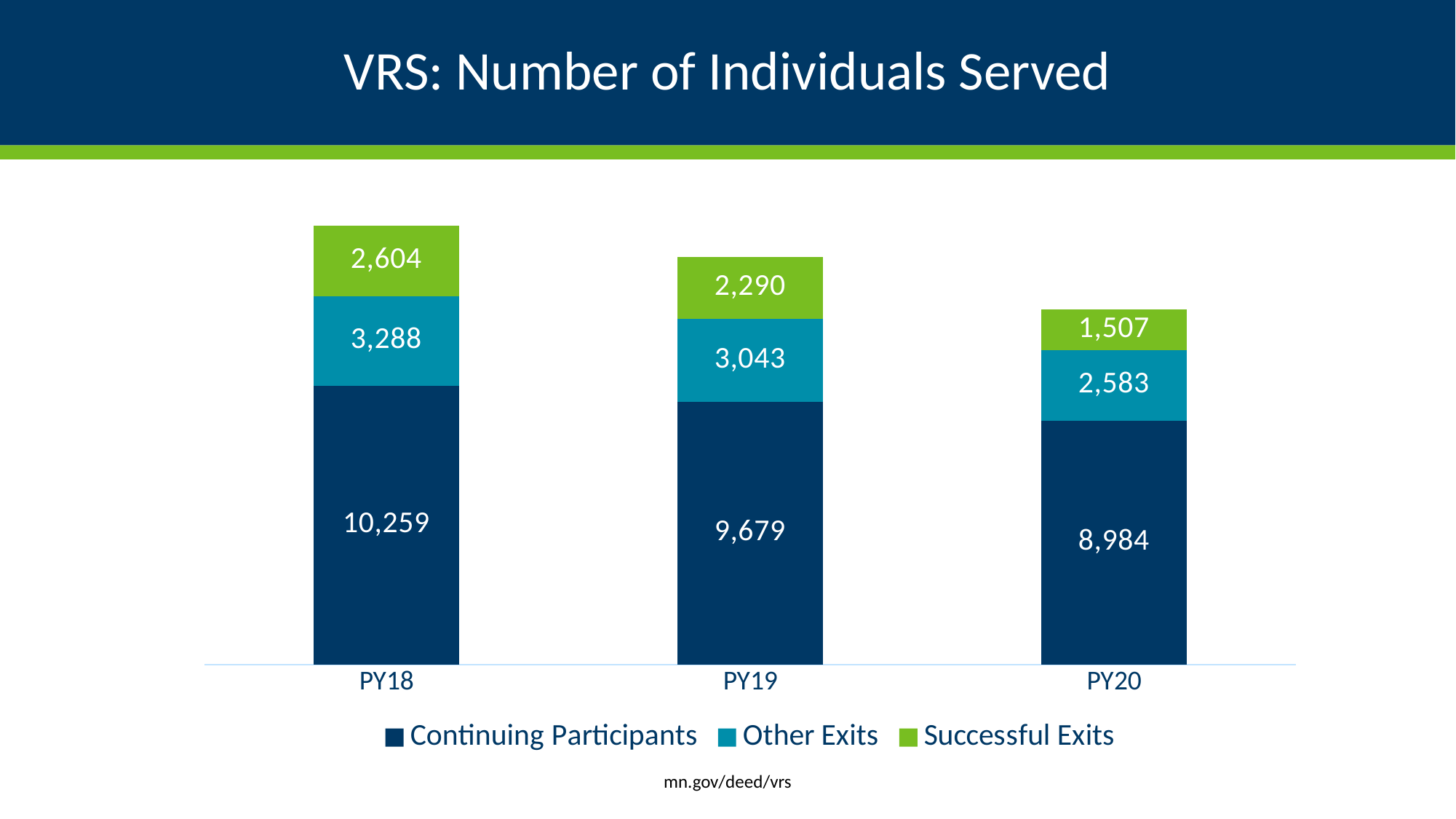
What kind of chart is shown on the slide? Stacked bar chart What is the value for Other Exits in PY18? 3,288 What is the total number of individuals served in PY20 (sum of the stacked bar)? 13,074 How many series does the legend list? 3 What is the difference between Successful Exits in PY18 and PY19? 314 Which program year has the lowest number of Successful Exits? PY20 What is the value for Successful Exits in PY20? 1,507 Which program year has the highest number of Continuing Participants? PY18 Which is larger: Other Exits in PY19 or Other Exits in PY20? Other Exits in PY19 How many program years are shown on the x axis? 3 What is the value for Continuing Participants in PY19? 9,679 What is the difference between Continuing Participants in PY18 and PY20? 1,275